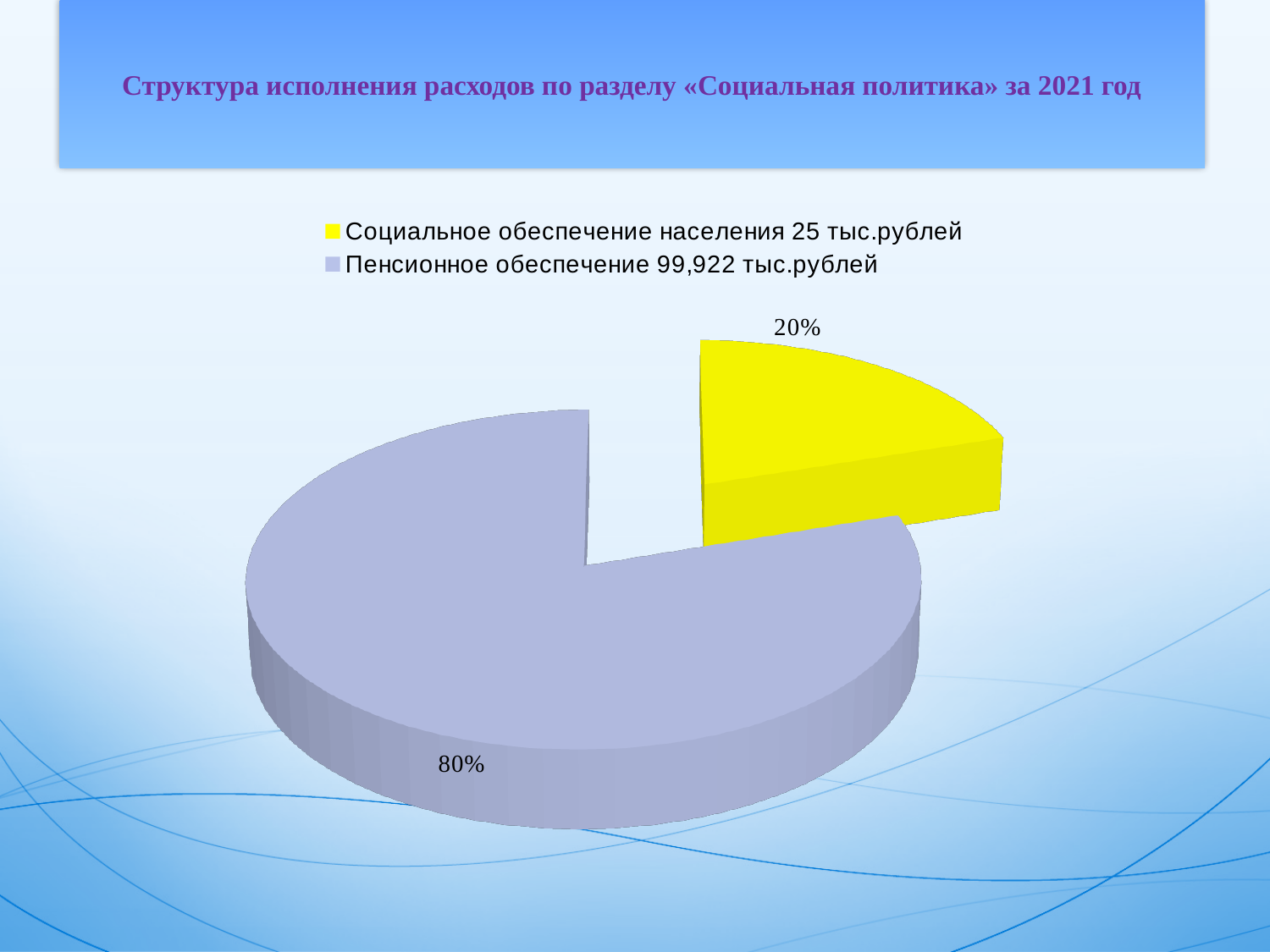
What share of the pie does the slice for Пенсионное обеспечение represent? 80% What amount in thousand rubles does the legend give for Социальное обеспечение населения? 25 тыс.рублей What colour is the slice for Социальное обеспечение населения? Yellow How many entries does the legend list? 2 What share of the pie does the slice for Социальное обеспечение населения represent? 20% What is the difference in percentage points between the Пенсионное обеспечение slice and the Социальное обеспечение населения slice? 60 percentage points What amount in thousand rubles does the legend give for Пенсионное обеспечение? 99,922 тыс.рублей Which category has the smallest slice of the pie? Социальное обеспечение населения What kind of chart is shown on the slide? Pie chart Which slice is larger: Социальное обеспечение населения or Пенсионное обеспечение? Пенсионное обеспечение How many slices does the pie chart have? 2 Which category has the largest slice of the pie? Пенсионное обеспечение